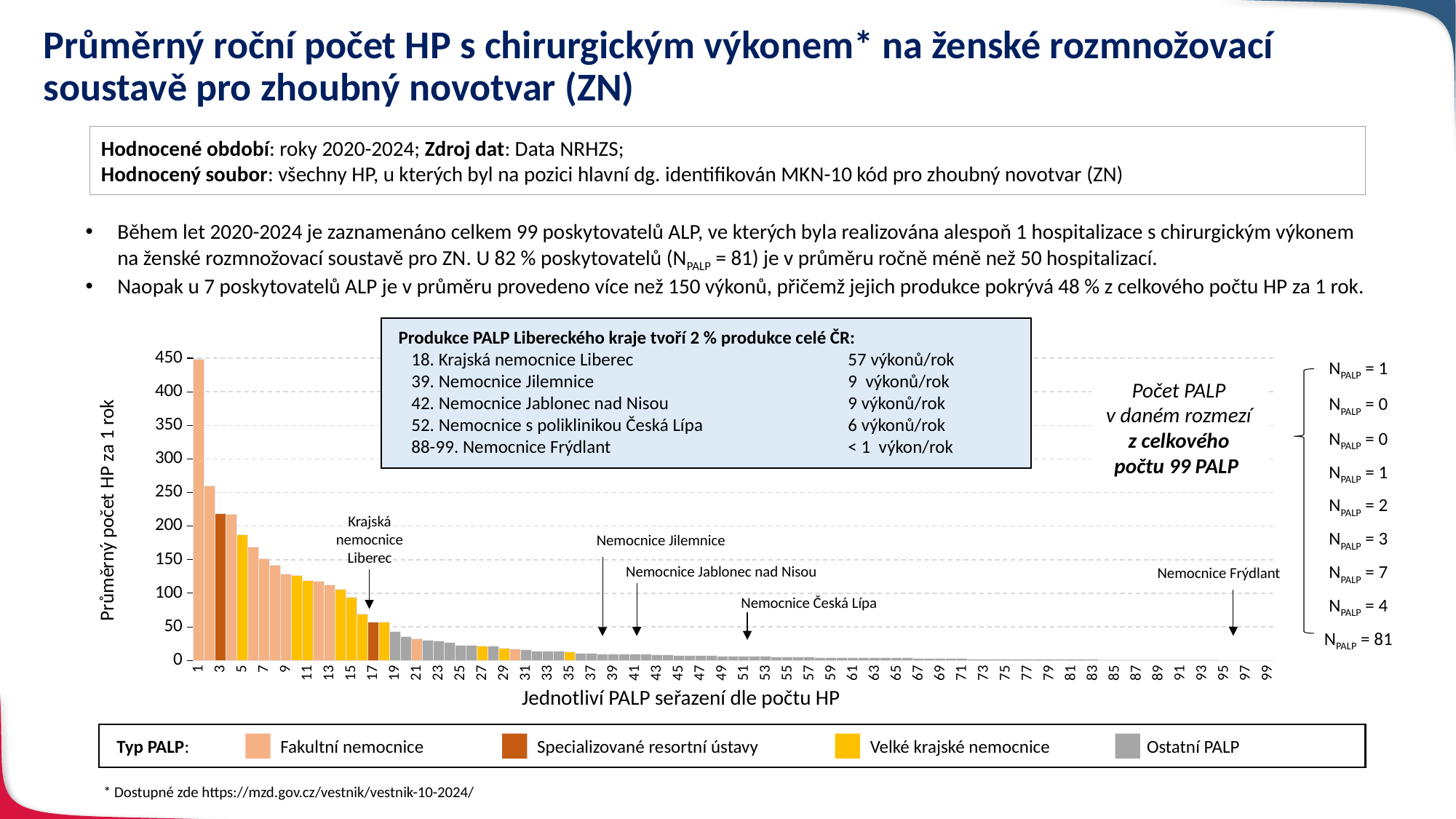
Do the bar values rise or fall from left to right along the x axis? fall Which colour does the legend use for Velké krajské nemocnice? yellow How many PALP (providers) are plotted along the x axis of the chart? 99 What kind of chart is shown on the slide? bar chart How many PALP types does the legend (Typ PALP) list? 4 Which has the larger value, Krajská nemocnice Liberec or Nemocnice Jilemnice? Krajská nemocnice Liberec Is the value of the bar for Krajská nemocnice Liberec greater or less than 100? less What is the difference in výkonů/rok between Krajská nemocnice Liberec and Nemocnice Jilemnice? 48 výkonů/rok Is the value of the first (leftmost) bar greater or less than 400? greater What rank (position on the x axis) does Krajská nemocnice Liberec hold according to the box on the chart? 18 According to the box on the chart, how many výkonů/rok does Krajská nemocnice Liberec have? 57 výkonů/rok According to the box on the chart, how many výkonů/rok does Nemocnice s poliklinikou Česká Lípa have? 6 výkonů/rok